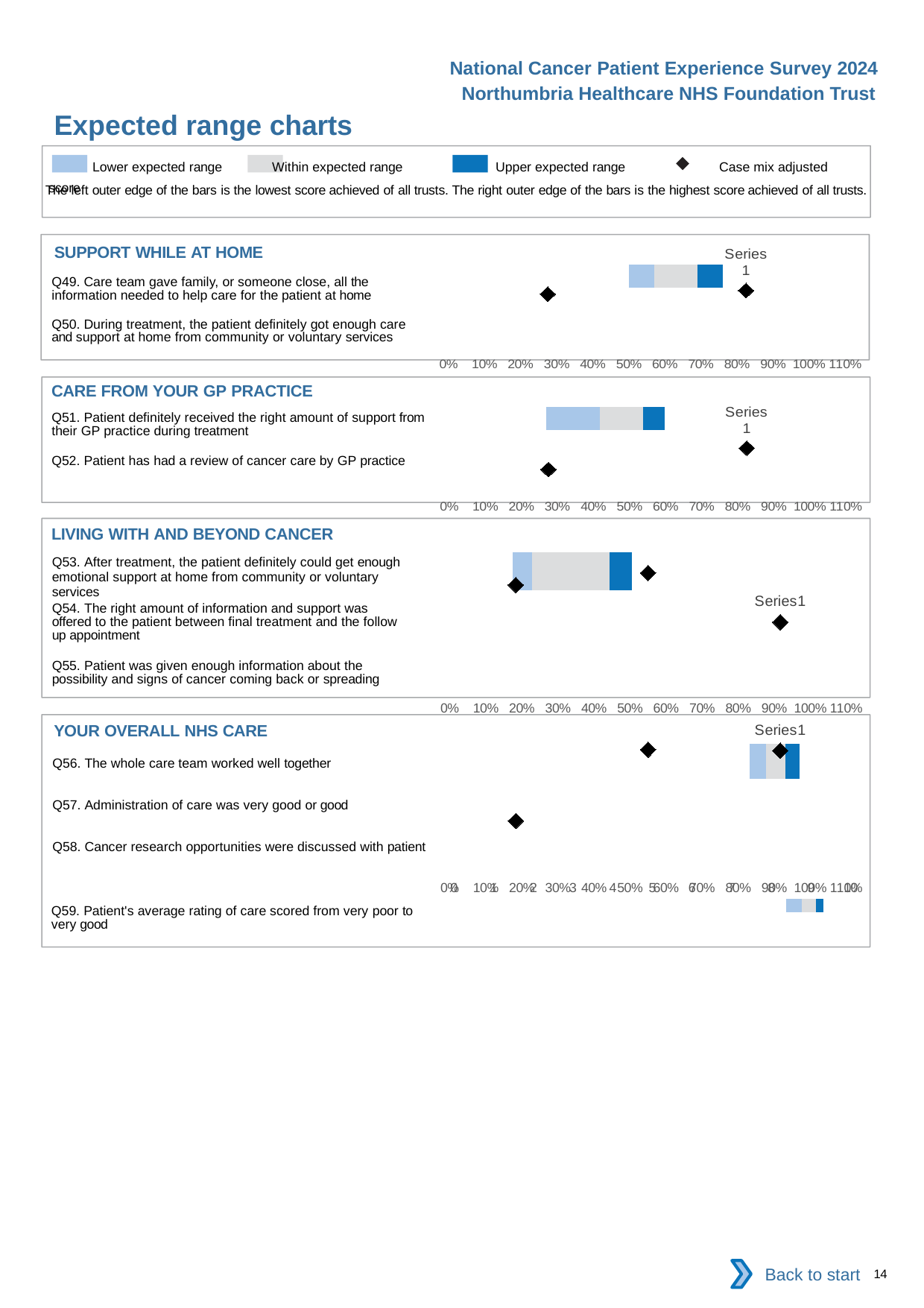
How many questions are listed in the 'LIVING WITH AND BEYOND CANCER' chart? 3 How many questions are listed in the 'SUPPORT WHILE AT HOME' chart? 2 How many questions are listed in the 'YOUR OVERALL NHS CARE' chart? 4 What kind of chart is used in the 'SUPPORT WHILE AT HOME' section? bar chart According to the legend, what does the diamond marker represent? Case mix adjusted score According to the legend, which colour represents the upper expected range? dark blue What is the highest value shown on the x axis of the 'CARE FROM YOUR GP PRACTICE' chart? 110% What is the lowest value shown on the x axis of the 'LIVING WITH AND BEYOND CANCER' chart? 0% How many entries does the legend at the top of the slide list? 4